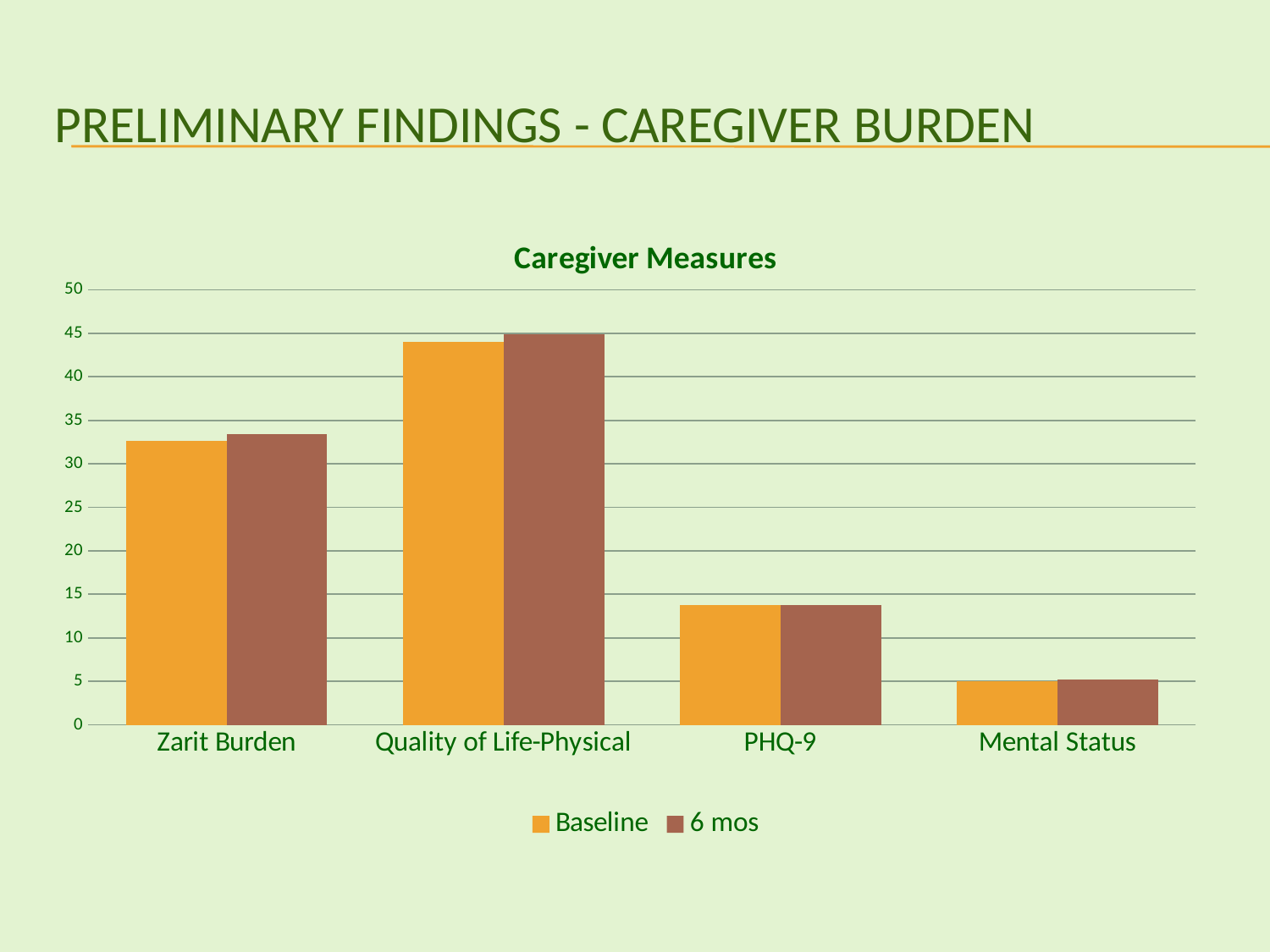
Is the Baseline value for Mental Status greater or less than 10? less Is the 6 mos value for Quality of Life-Physical greater or less than 40? greater Is the Baseline value for Zarit Burden greater or less than 30? greater Which is larger, the Baseline value for Quality of Life-Physical or the Baseline value for PHQ-9? Quality of Life-Physical How many series does the legend list? 2 Which category has the lowest 6 mos value? Mental Status What type of chart is shown on the slide? bar chart How many categories are shown on the x axis? 4 Which category has the highest Baseline value? Quality of Life-Physical What are the two series named in the legend? Baseline and 6 mos What is the title of the chart? Caregiver Measures